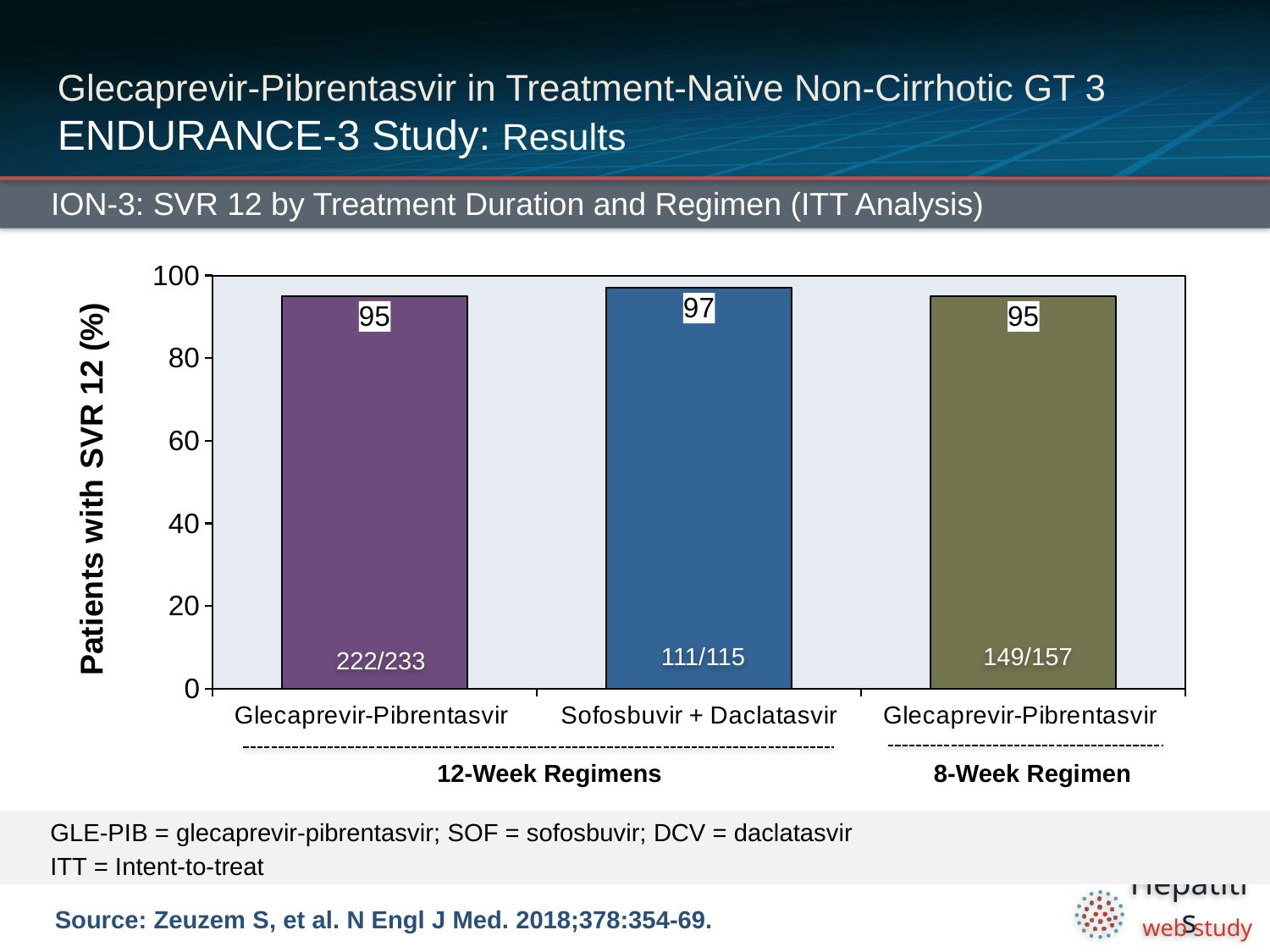
What is the SVR 12 rate for Glecaprevir-Pibrentasvir in the 12-week regimens? 95 How many bars are plotted in the chart? 3 What kind of chart is shown on the slide? Bar chart What is the difference in SVR 12 rate between Sofosbuvir + Daclatasvir and the 8-week Glecaprevir-Pibrentasvir regimen? 2 Which regimen has the highest SVR 12 rate? Sofosbuvir + Daclatasvir What is the label of the y-axis? Patients with SVR 12 (%) Is the SVR 12 rate for the 12-week Glecaprevir-Pibrentasvir regimen greater or less than 80? greater What is the SVR 12 rate for Glecaprevir-Pibrentasvir in the 8-week regimen? 95 What fraction of patients is shown inside the 12-week Glecaprevir-Pibrentasvir bar? 222/233 What fraction of patients is shown inside the 8-week Glecaprevir-Pibrentasvir bar? 149/157 What is the SVR 12 rate for Sofosbuvir + Daclatasvir in the 12-week regimens? 97 What fraction of patients is shown inside the Sofosbuvir + Daclatasvir bar? 111/115